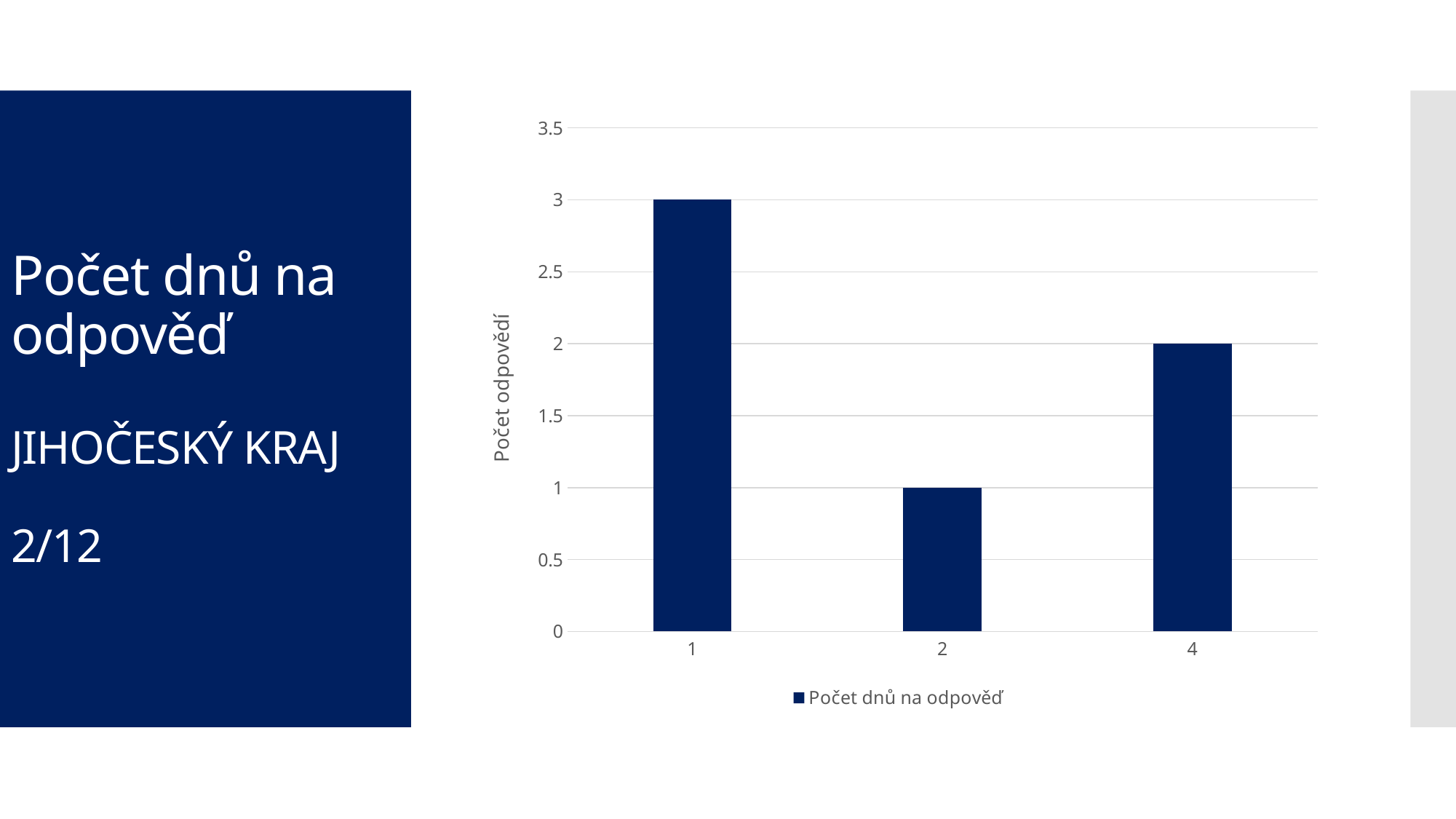
How many bars (categories) does the chart show? 3 Which is larger, the value for category 4 or the value for category 2? 4 What series name does the legend show? Počet dnů na odpověď What kind of chart is shown on the slide? bar chart What is the value for category 1? 3 What is the value for category 2? 1 Which category has the highest value? 1 What is the difference between the values for category 1 and category 2? 2 What is the value for category 4? 2 Which category has the lowest value? 2 How many series does the legend list? 1 What is the label of the vertical axis? Počet odpovědí